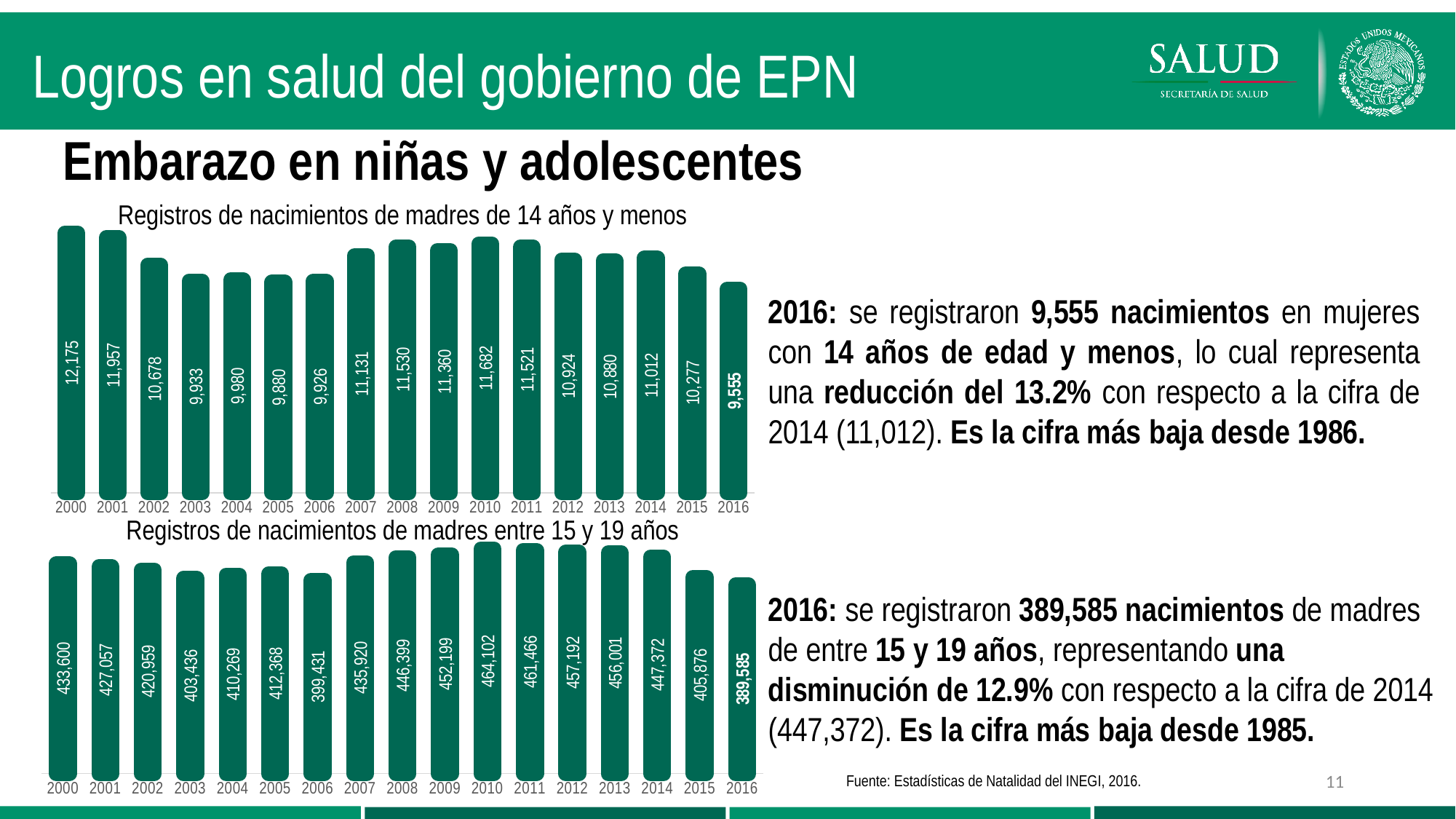
In the chart 'Registros de nacimientos de madres entre 15 y 19 años', which year has the highest value? 2010 In the chart 'Registros de nacimientos de madres de 14 años y menos', what is the value for 2016? 9,555 In the chart 'Registros de nacimientos de madres entre 15 y 19 años', what is the difference between the values for 2014 and 2016? 57,787 In the chart 'Registros de nacimientos de madres de 14 años y menos', which is larger, the value for 2010 or the value for 2005? 2010 In the chart 'Registros de nacimientos de madres de 14 años y menos', which year has the lowest value? 2016 What kind of chart is 'Registros de nacimientos de madres de 14 años y menos'? Bar chart In the chart 'Registros de nacimientos de madres entre 15 y 19 años', do the values rise or fall from 2014 to 2016? Fall How many years are shown in the chart 'Registros de nacimientos de madres entre 15 y 19 años'? 17 In the chart 'Registros de nacimientos de madres entre 15 y 19 años', which year has the lowest value? 2016 In the chart 'Registros de nacimientos de madres entre 15 y 19 años', what is the value for 2010? 464,102 In the chart 'Registros de nacimientos de madres de 14 años y menos', what is the difference between the values for 2014 and 2016? 1,457 In the chart 'Registros de nacimientos de madres de 14 años y menos', which year has the highest value? 2000